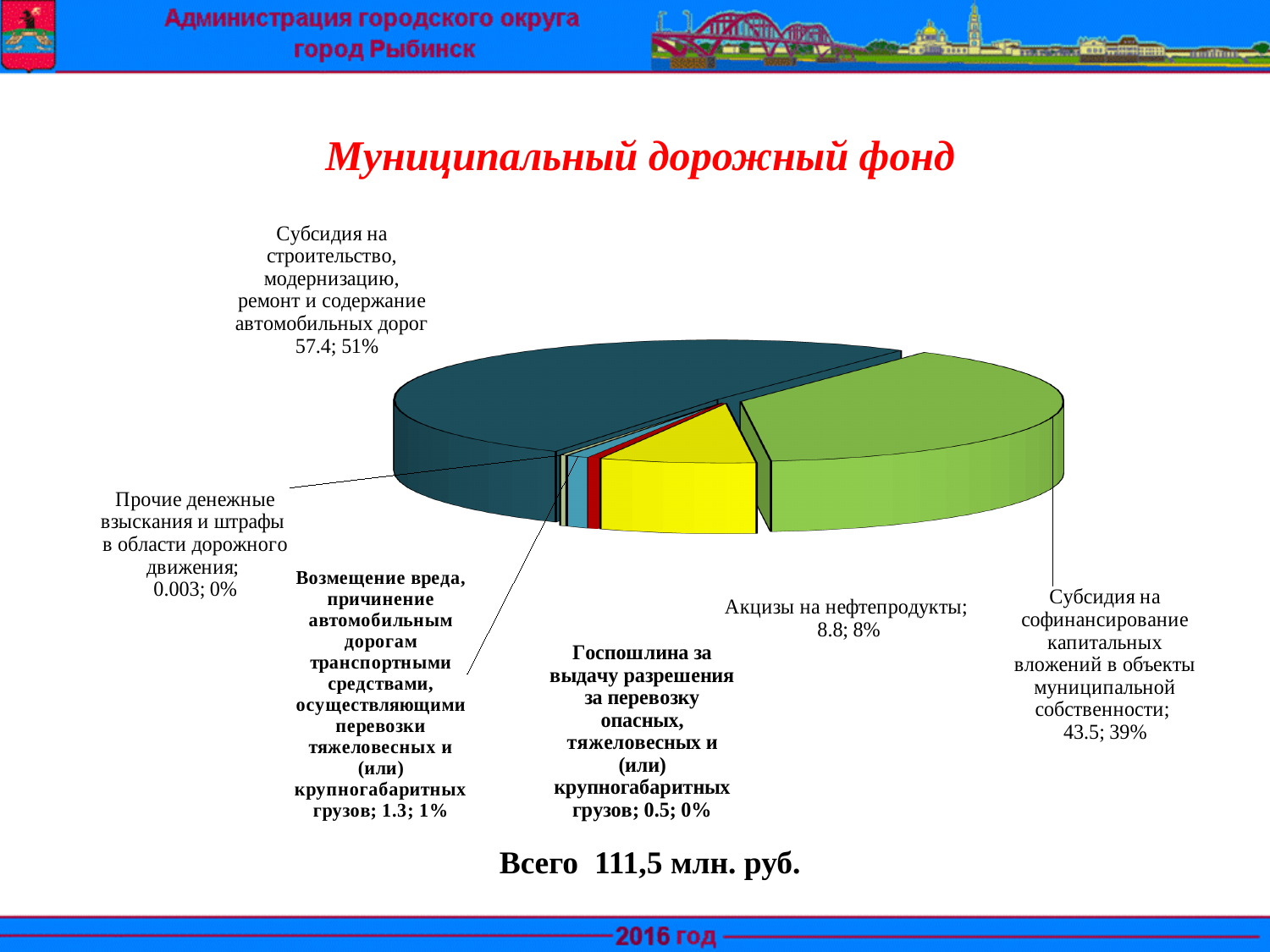
Which category has the smallest value? Прочие денежные взыскания и штрафы в области дорожного движения Which category has the largest slice of the pie? Субсидия на строительство, модернизацию, ремонт и содержание автомобильных дорог What share of the pie does 'Субсидия на софинансирование капитальных вложений в объекты муниципальной собственности' represent? 39% What is the title of the chart? Муниципальный дорожный фонд What is the value for 'Акцизы на нефтепродукты'? 8.8 What share of the pie does 'Акцизы на нефтепродукты' represent? 8% Which is larger: the value for 'Возмещение вреда...' or the value for 'Госпошлина за выдачу разрешения...'? Возмещение вреда... How many slices does the pie chart have? 6 What total amount is stated below the chart? 111,5 млн. руб. What kind of chart is shown on the slide? Pie chart What is the difference between the values for 'Субсидия на строительство, модернизацию, ремонт и содержание автомобильных дорог' and 'Субсидия на софинансирование капитальных вложений в объекты муниципальной собственности'? 13.9 What is the value for 'Субсидия на строительство, модернизацию, ремонт и содержание автомобильных дорог'? 57.4